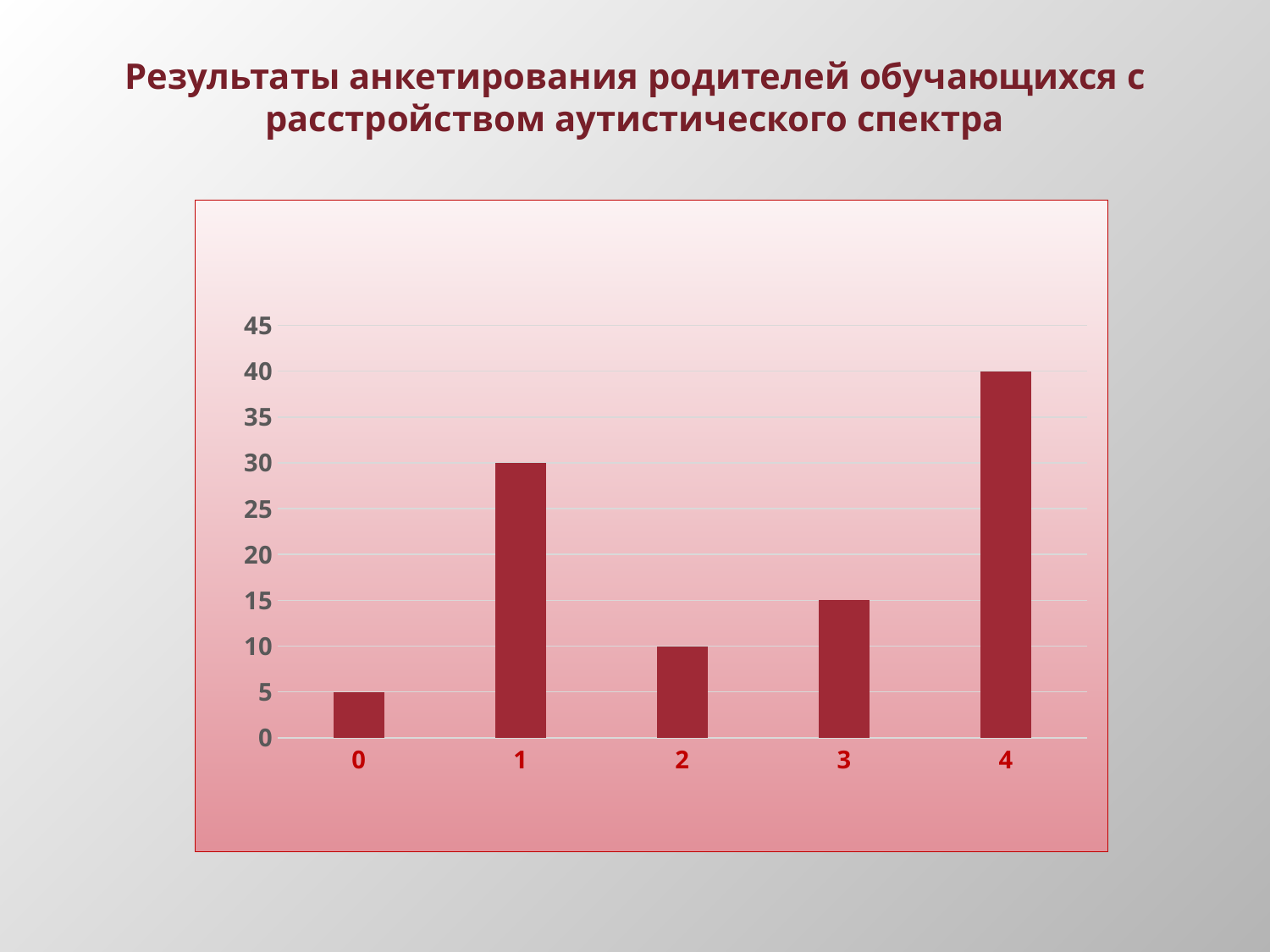
What is the value for category 0? 5 Which is larger, the value for category 2 or the value for category 3? 3 Which category has the lowest value? 0 What is the value for category 4? 40 How many categories are shown on the x axis of the chart? 5 Is the value for category 2 greater or less than 20? less What is the title of the slide containing the chart? Результаты анкетирования родителей обучающихся с расстройством аутистического спектра Which category has the highest value? 4 What is the value for category 1? 30 What is the difference between the values for category 4 and category 1? 10 What is the value for category 3? 15 What kind of chart is shown on the slide? bar chart